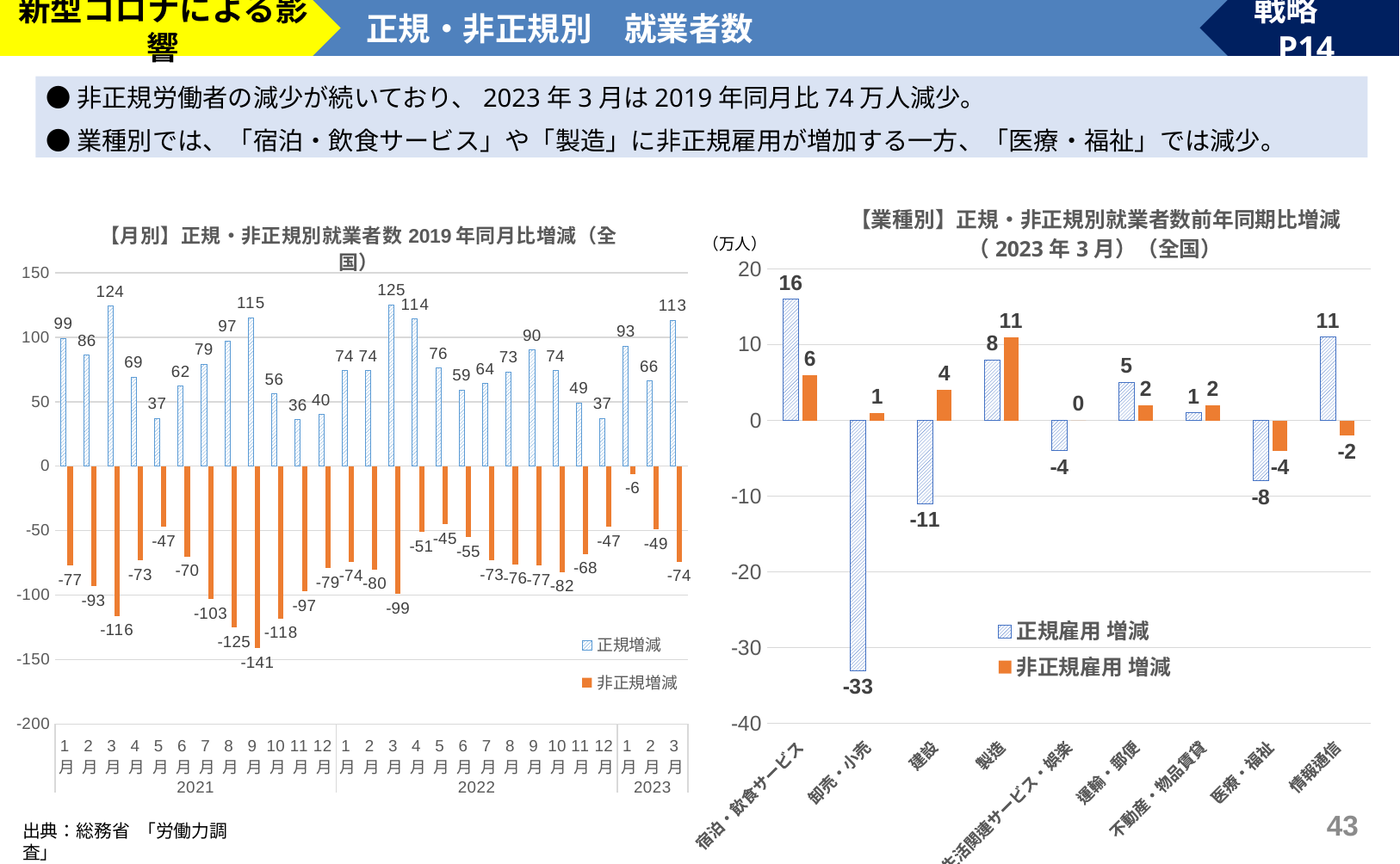
In the left chart (【月別】), what is the 正規増減 value for 2023年1月? 93 In the right chart (【業種別】), what is the 正規雇用 増減 value for 宿泊・飲食サービス? 16 In the right chart (【業種別】), what is the 非正規雇用 増減 value for 医療・福祉? -4 In the right chart (【業種別】), for 製造, which is larger: 正規雇用 増減 or 非正規雇用 増減? 非正規雇用 増減 In the right chart (【業種別】), what is the difference between the 正規雇用 増減 and 非正規雇用 増減 values for 宿泊・飲食サービス? 10 In the right chart (【業種別】), how many series does the legend list? 2 In the right chart (【業種別】), what is the 非正規雇用 増減 value for 製造? 11 In the right chart (【業種別】), which industry has the lowest 正規雇用 増減 value? 卸売・小売 In the left chart (【月別】), which month has the lowest 非正規増減 value? 2021年9月 In the left chart (【月別】), what is the 非正規増減 value for 2023年3月? -74 In the right chart (【業種別】), how many industry categories are shown on the x axis? 9 What kind of chart is the left chart (【月別】)? bar chart